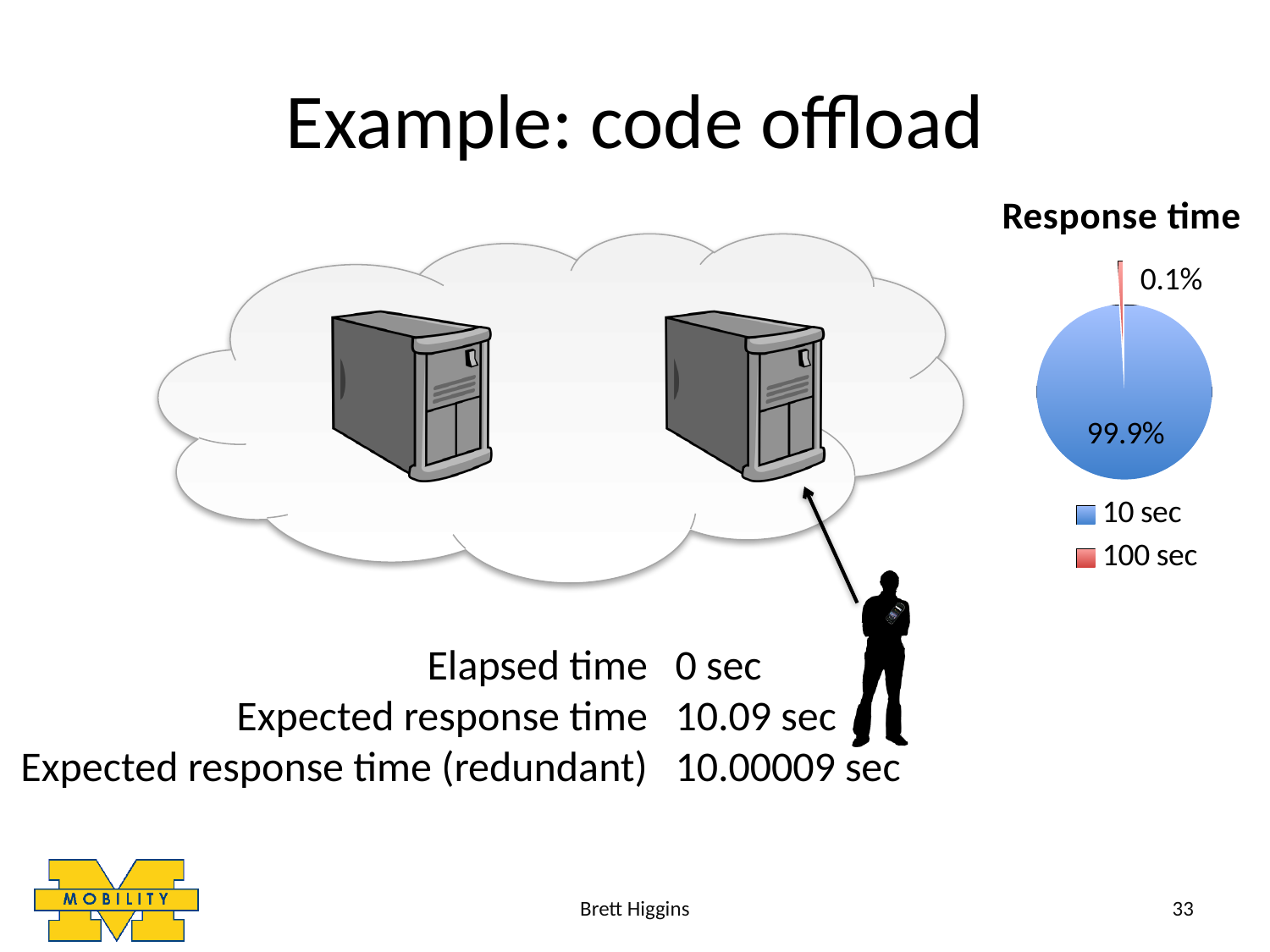
What kind of chart is shown under the title "Response time"? pie chart What share of the "Response time" pie does the "10 sec" slice have? 99.9% What share of the "Response time" pie does the "100 sec" slice have? 0.1% Which slice of the "Response time" pie is the largest? 10 sec What is the title of the pie chart on the slide? Response time Which slice of the "Response time" pie is the smallest? 100 sec What colour is the "100 sec" slice in the "Response time" pie chart? red How many slices does the "Response time" pie chart have? 2 How many entries does the legend of the "Response time" pie chart list? 2 In the "Response time" pie chart, which slice is larger: "10 sec" or "100 sec"? 10 sec What is the difference in percentage points between the "10 sec" and "100 sec" slices of the "Response time" pie? 99.8%